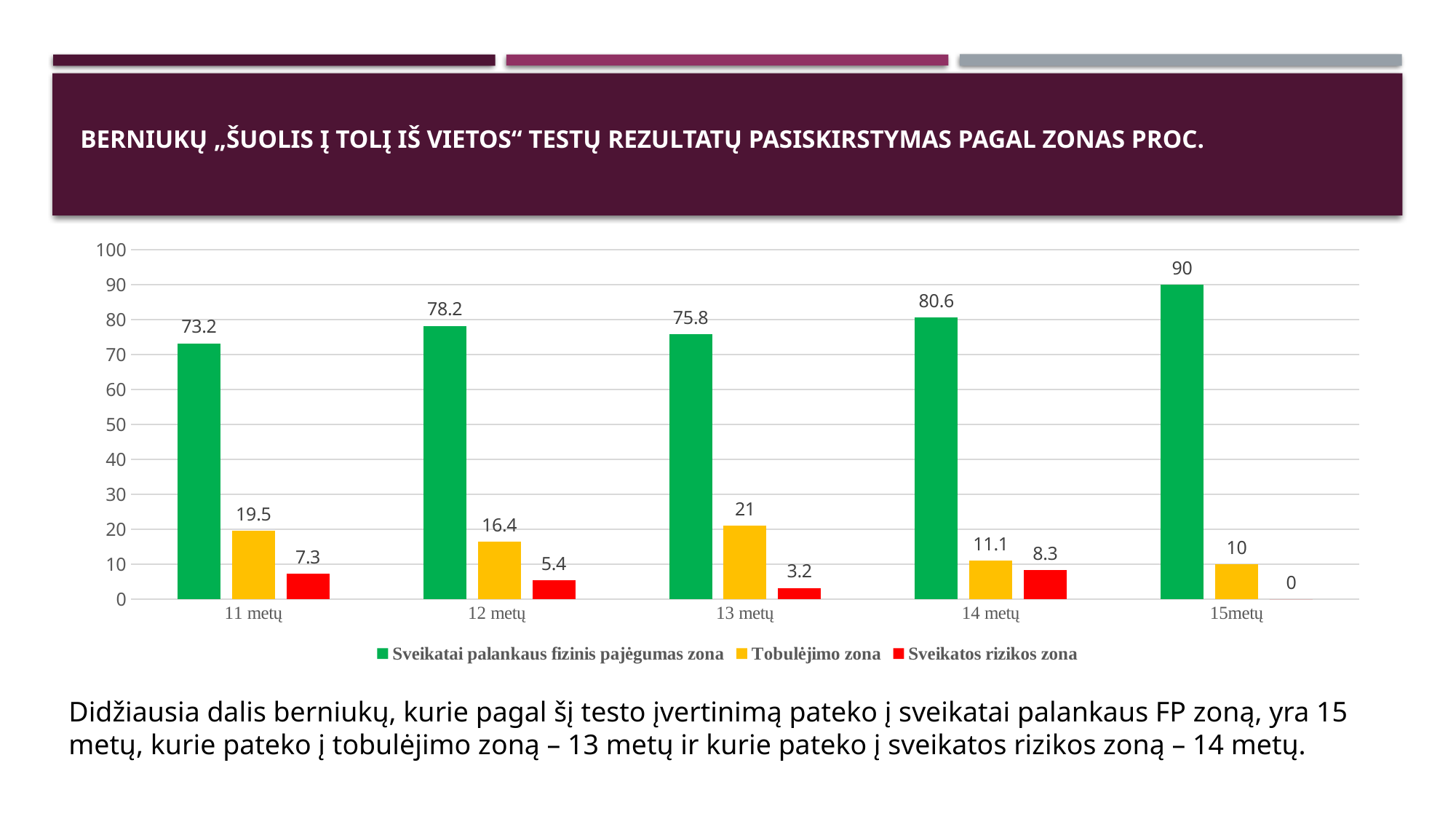
How many age groups are shown on the x axis? 5 What colour are the bars for 'Sveikatos rizikos zona'? red What is the value for 'Sveikatai palankaus fizinis pajėgumas zona' at 11 metų? 73.2 Is the value for 'Sveikatai palankaus fizinis pajėgumas zona' at 14 metų greater or less than 80? greater Which age group has the lowest value for 'Tobulėjimo zona'? 15metų Which age group has the highest value for 'Sveikatai palankaus fizinis pajėgumas zona'? 15metų What is the difference between the 'Sveikatai palankaus fizinis pajėgumas zona' values for 15metų and 11 metų? 16.8 How many series does the legend list? 3 What is the value for 'Tobulėjimo zona' at 13 metų? 21 Which is larger: the 'Sveikatos rizikos zona' value for 14 metų or for 12 metų? 14 metų What kind of chart is shown on the slide? bar chart What is the value for 'Sveikatos rizikos zona' at 15metų? 0